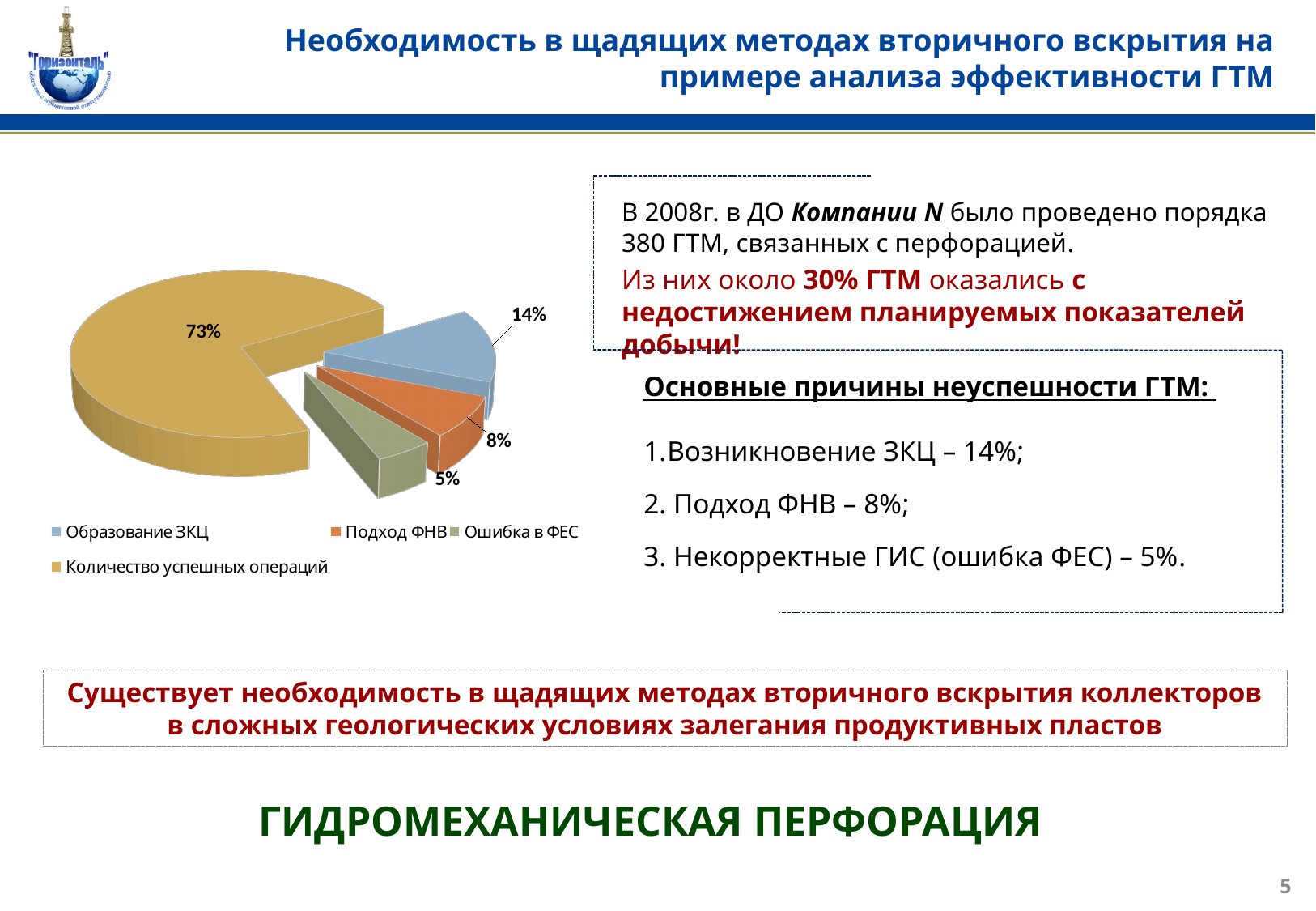
Which is larger, the slice for Подход ФНВ or the slice for Ошибка в ФЕС? Подход ФНВ What percentage does the slice for Подход ФНВ show? 8% What percentage does the slice for Количество успешных операций show? 73% What is the difference in percentage points between Образование ЗКЦ and Подход ФНВ? 6 What percentage does the slice for Ошибка в ФЕС show? 5% Which category has the largest slice of the pie? Количество успешных операций What kind of chart is shown on the slide? pie chart How many slices does the pie chart have? 4 What percentage does the slice for Образование ЗКЦ show? 14% Which category has the smallest slice of the pie? Ошибка в ФЕС How many entries does the legend list? 4 What colour is the slice for Количество успешных операций? gold